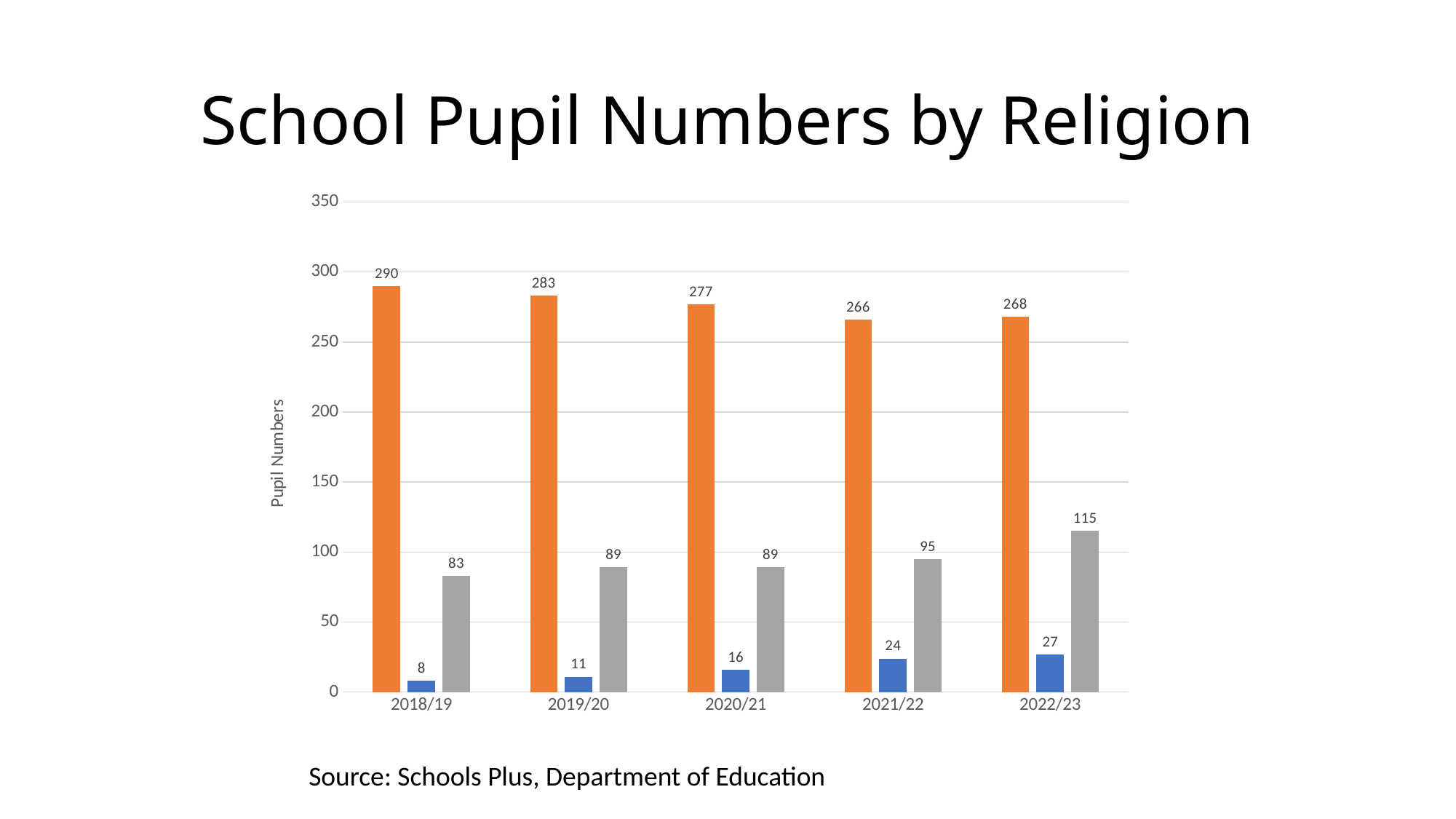
What is the label on the vertical axis? Pupil Numbers Do the blue bar values rise or fall from 2018/19 to 2022/23? Rise What is the value of the blue bar for 2020/21? 16 What is the difference between the grey bar values for 2021/22 and 2022/23? 20 What is the value of the grey bar for 2022/23? 115 In which year is the blue bar lowest? 2018/19 Which is larger, the grey bar for 2018/19 or the grey bar for 2021/22? 2021/22 What is the difference between the orange bar values for 2018/19 and 2022/23? 22 How many years are shown on the x axis? 5 What is the value of the orange bar for 2018/19? 290 What kind of chart is shown on the slide? Bar chart In which year is the orange bar highest? 2018/19